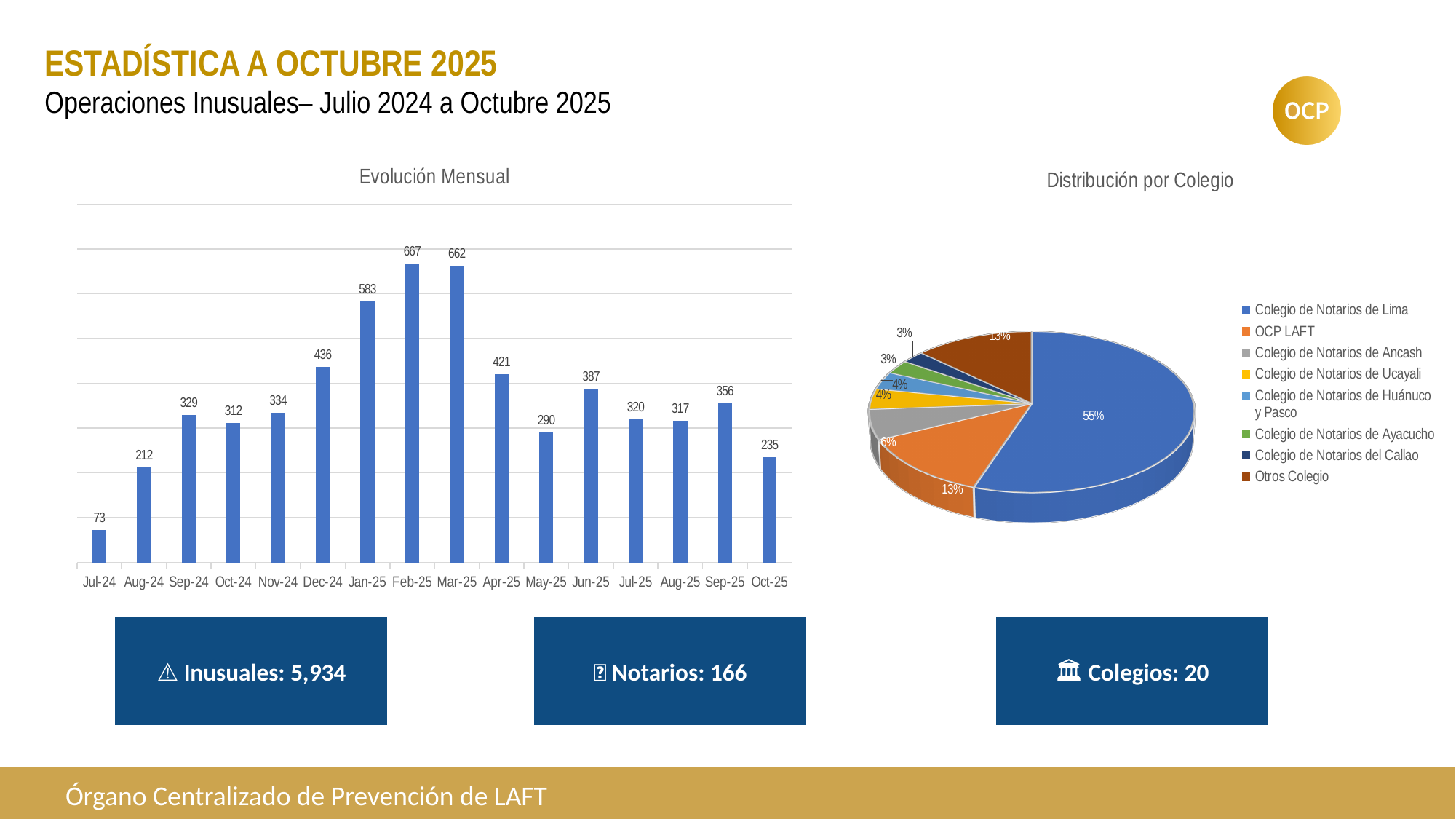
In the Evolución Mensual chart, what is the difference between the values for Jan-25 and Dec-24? 147 How many entries does the legend of the Distribución por Colegio chart list? 8 In the Evolución Mensual chart, what is the value for Jul-24? 73 In the Distribución por Colegio chart, what share does Colegio de Notarios de Ancash have? 6% How many months are shown in the Evolución Mensual chart? 16 In the Evolución Mensual chart, which month has the lowest value? Jul-24 What kind of chart is the Evolución Mensual chart? Bar chart In the Evolución Mensual chart, which month has the highest value? Feb-25 In the Evolución Mensual chart, what is the value for Feb-25? 667 In the Evolución Mensual chart, which is larger, the value for Sep-25 or the value for Jun-25? Jun-25 In the Evolución Mensual chart, do the values rise or fall from Mar-25 to May-25? Fall In the Distribución por Colegio chart, what share does Colegio de Notarios de Lima have? 55%